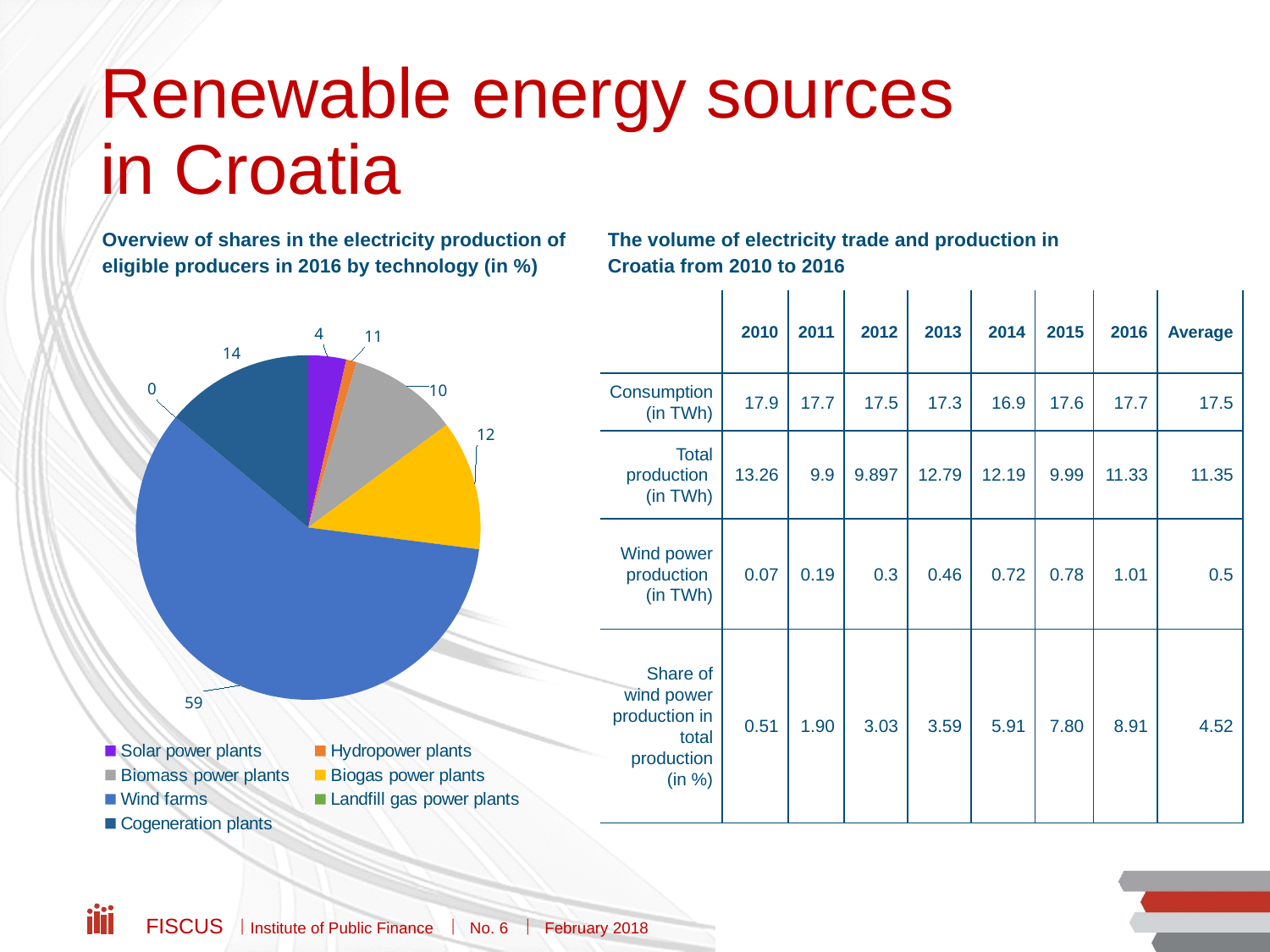
How many technologies are listed in the pie chart's legend? 7 What colour represents wind farms in the pie chart? Blue Which technology has the smallest share in the pie chart? Landfill gas power plants In the pie chart, what is the share for cogeneration plants? 14 In the pie chart, what is the share for solar power plants? 4 In the pie chart, what is the share for biogas power plants? 12 In the pie chart, what share of electricity production do wind farms have? 59 In the pie chart, how much larger is the share of wind farms than the share of cogeneration plants? 45 Which technology has the largest slice in the pie chart? Wind farms In the pie chart, what is the share for biomass power plants? 10 What kind of chart is shown on the left of the slide? pie chart In the pie chart, which has a larger share: biogas power plants or cogeneration plants? Cogeneration plants